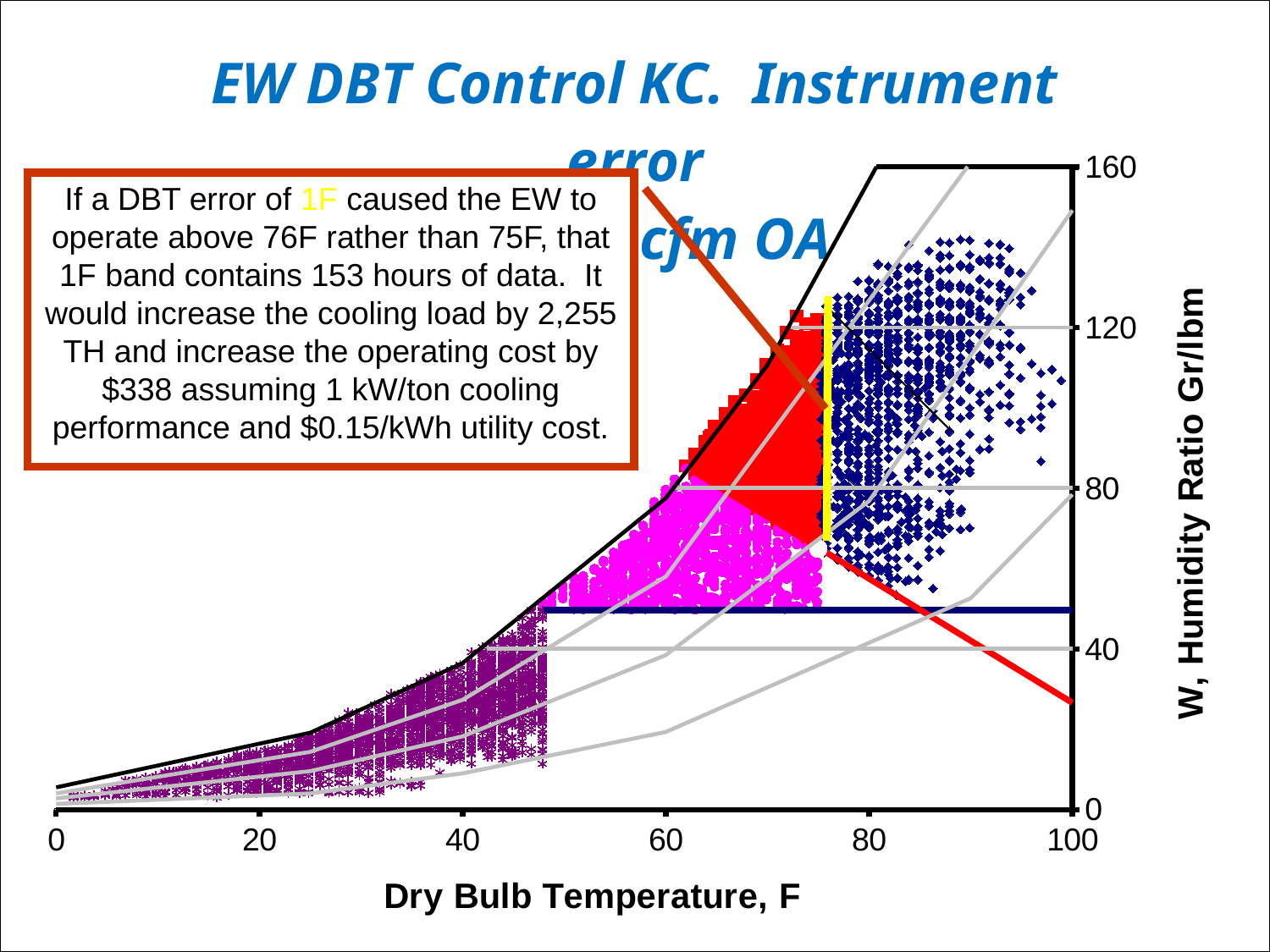
How many tick labels are shown on the x axis of the chart? 6 According to the text box on the chart, by how much would the cooling load increase? 2,255 TH According to the text box on the chart, how many hours of data does the 1F band contain? 153 hours Is the yellow vertical line on the chart located at a dry bulb temperature greater or less than 60? greater What is the highest value shown on the y axis of the chart? 160 What is the highest value shown on the x axis of the chart? 100 According to the text box on the chart, by how much would the operating cost increase? $338 What is the label of the x axis of the chart? Dry Bulb Temperature, F According to the text box on the chart, what utility cost is assumed? $0.15/kWh What is the label of the y axis of the chart? W, Humidity Ratio Gr/lbm What kind of chart is shown on the slide? Scatter chart How many tick labels are shown on the y axis of the chart? 5